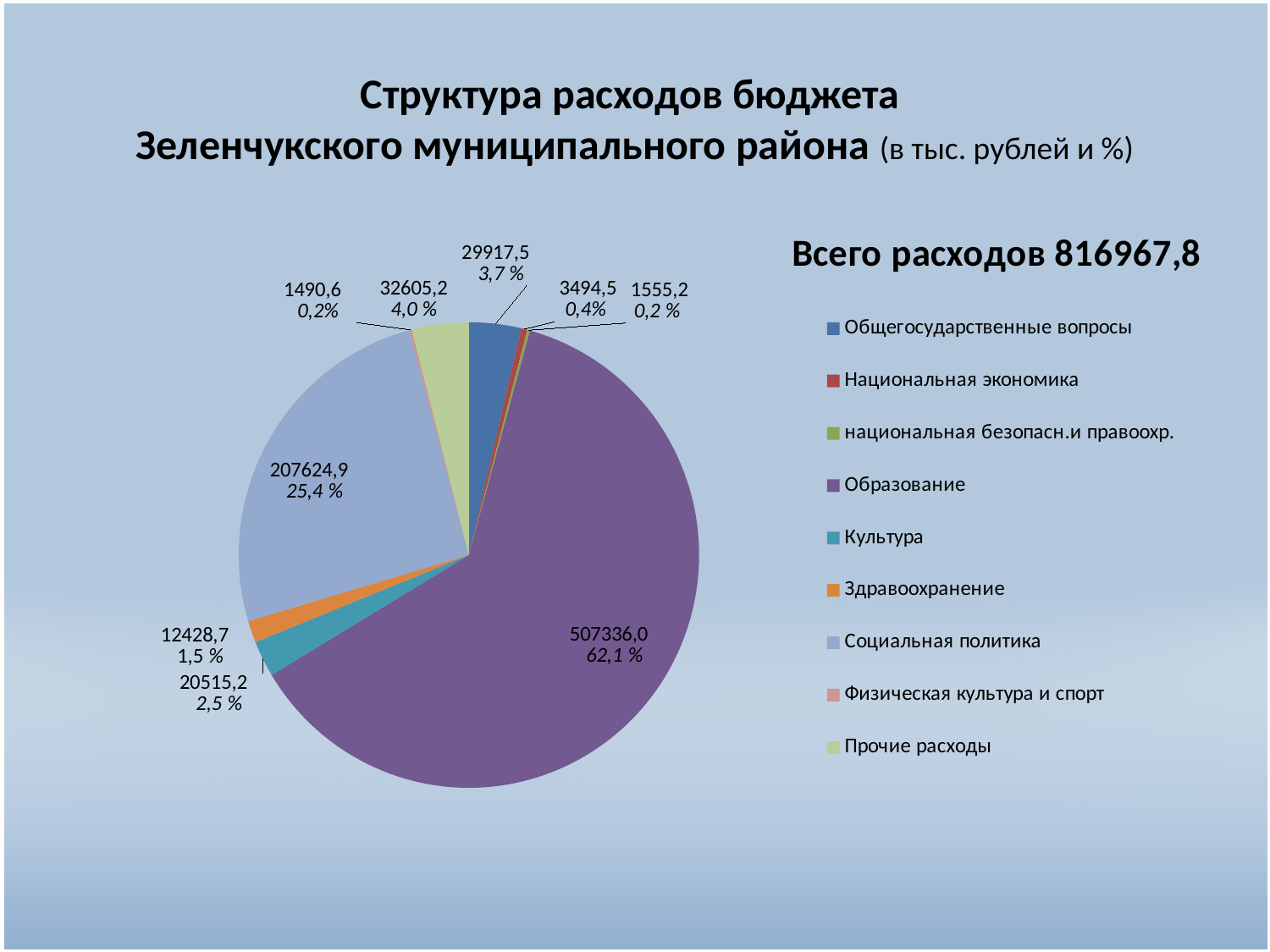
What share of the pie does Прочие расходы take? 4,0 % What is the value for Общегосударственные вопросы? 29917,5 What share of the pie does Социальная политика take? 25,4 % Which is larger, the value for Национальная экономика or the value for национальная безопасн.и правоохр.? Национальная экономика How many categories does the pie chart have? 9 What colour is the slice for Здравоохранение? orange What is the difference between the values for Культура and Здравоохранение? 8086,5 What is the value for Образование? 507336,0 Which category has the largest slice? Образование What kind of chart is shown on the slide? pie chart What total expenditure figure is stated on the slide? 816967,8 Which category has the smallest value? Физическая культура и спорт